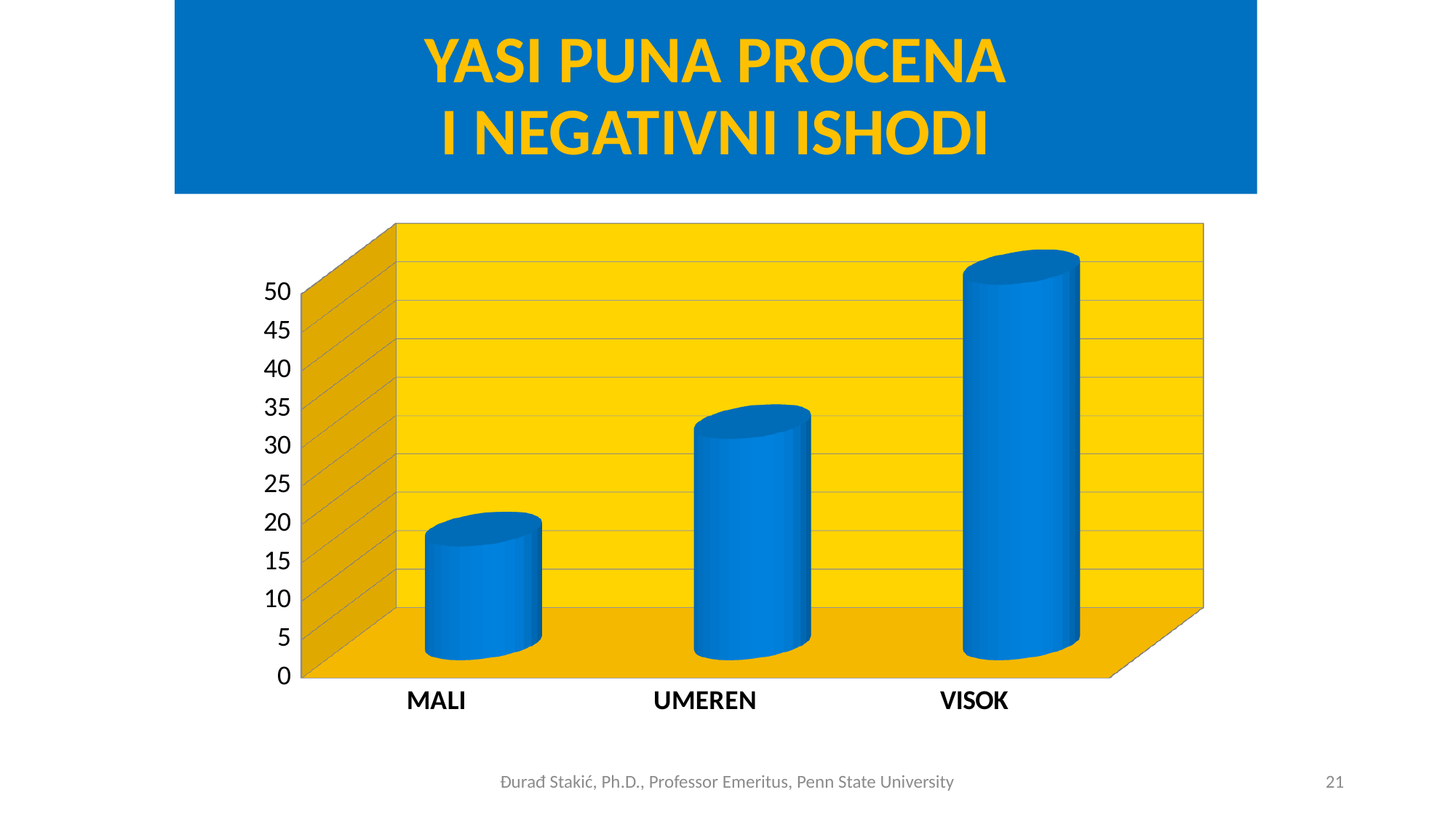
Which category has the highest value in the chart? VISOK Is the value for MALI greater or less than 25? less What is the title shown above the chart on the slide? YASI PUNA PROCENA I NEGATIVNI ISHODI Is the value for UMEREN greater or less than 40? less What kind of chart is shown on the slide? bar chart Which is larger, the value for UMEREN or the value for MALI? UMEREN Is the value for VISOK greater or less than 40? greater Which category has the lowest value in the chart? MALI Do the values rise or fall moving from MALI to VISOK along the x axis? rise How many categories are shown on the x axis of the chart? 3 Which is larger, the value for VISOK or the value for UMEREN? VISOK